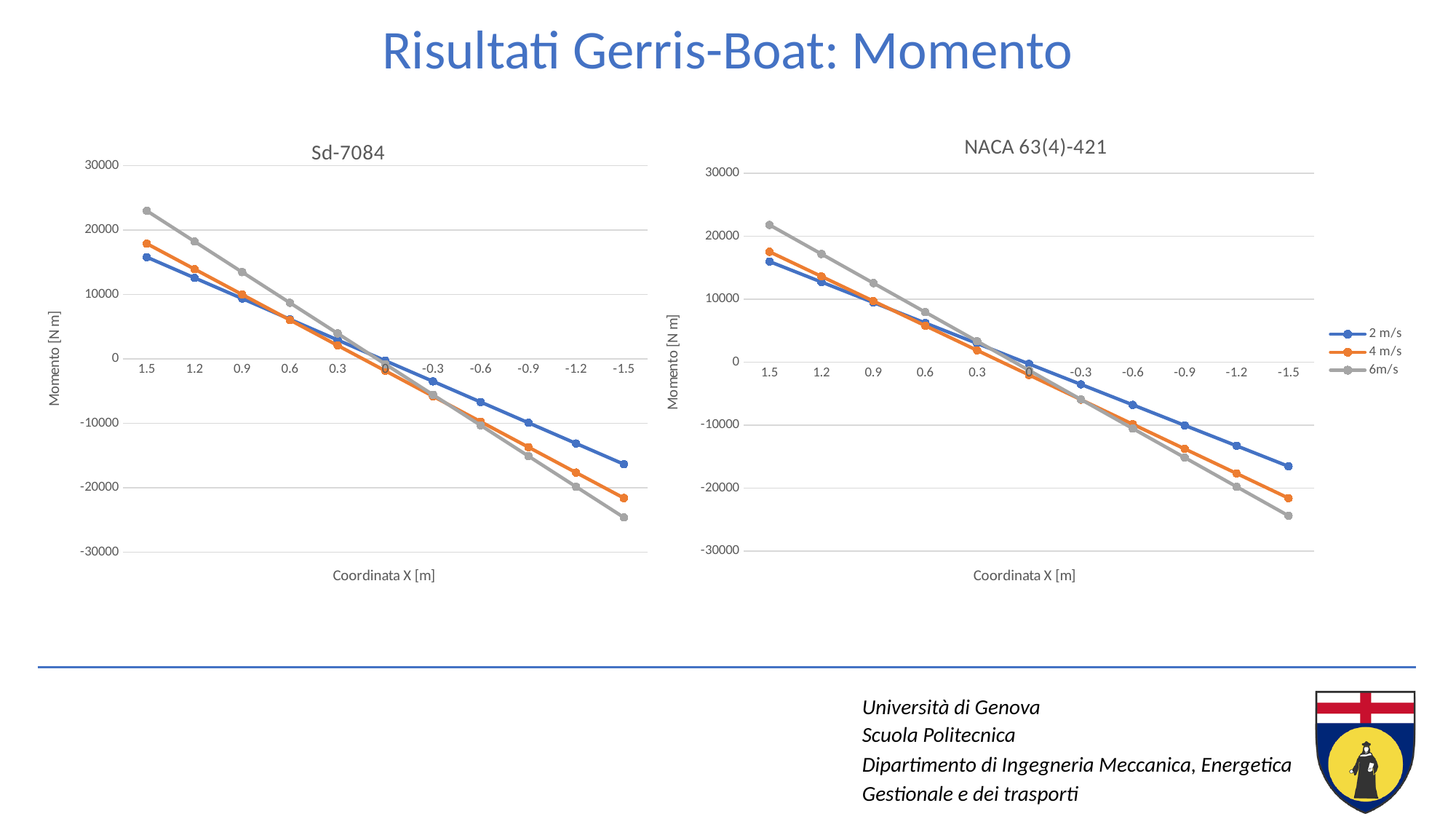
In the NACA 63(4)-421 chart, which series has the higher value at x = 1.5, 2 m/s or 6m/s? 6m/s In the NACA 63(4)-421 chart, which series has the lowest value at x = -1.5? 6m/s What kind of chart is the Sd-7084 chart? line chart In the Sd-7084 chart, which series has the highest value at x = 1.5? 6m/s In the Sd-7084 chart, does the 6m/s series rise or fall as the x axis goes from 1.5 to -1.5? fall In the Sd-7084 chart, is the value of the 6m/s series at x = 1.5 greater or less than 20000? greater What is the y-axis title of the Sd-7084 chart? Momento [N m] In the NACA 63(4)-421 chart, is the value of the 2 m/s series at x = -1.5 greater or less than -20000? greater How many series does the legend of the NACA 63(4)-421 chart list? 3 In the Sd-7084 chart, is the value of the 2 m/s series at x = 1.5 greater or less than 20000? less How many x-axis points are plotted in the Sd-7084 chart? 11